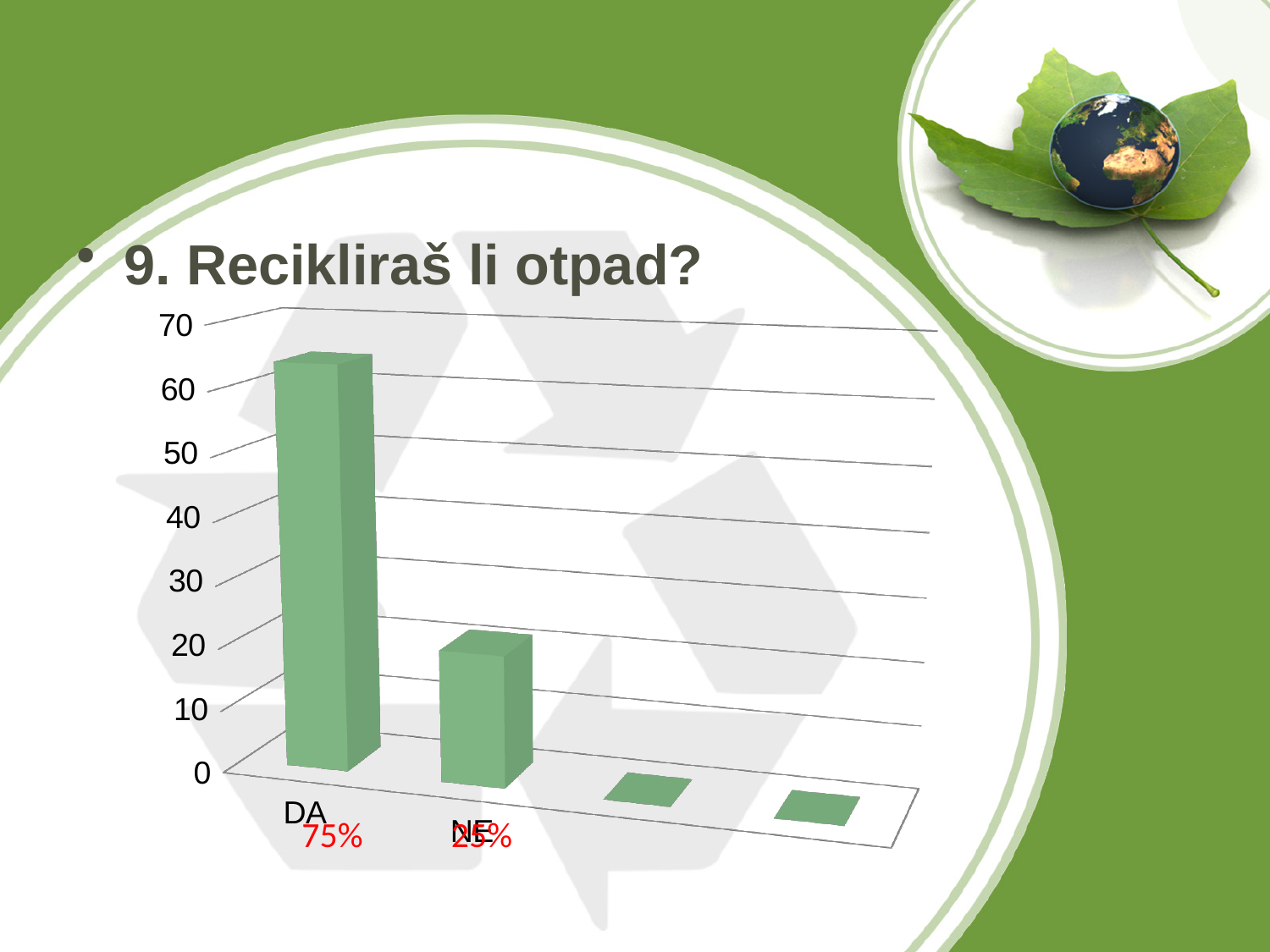
Which category has the tallest bar, DA or NE? DA What is the title of the chart? 9. Recikliraš li otpad? How many labelled categories are on the x axis? 2 What kind of chart is shown on the slide? bar chart Is the value for NE greater or less than 10? greater Is the value for NE greater or less than 30? less What percentage is written in red under the DA bar? 75% What is the highest value shown on the vertical axis? 70 Is the value for DA greater or less than 60? greater Is the bar for DA taller or shorter than the bar for NE? taller Which of the two labelled categories has the shorter bar? NE